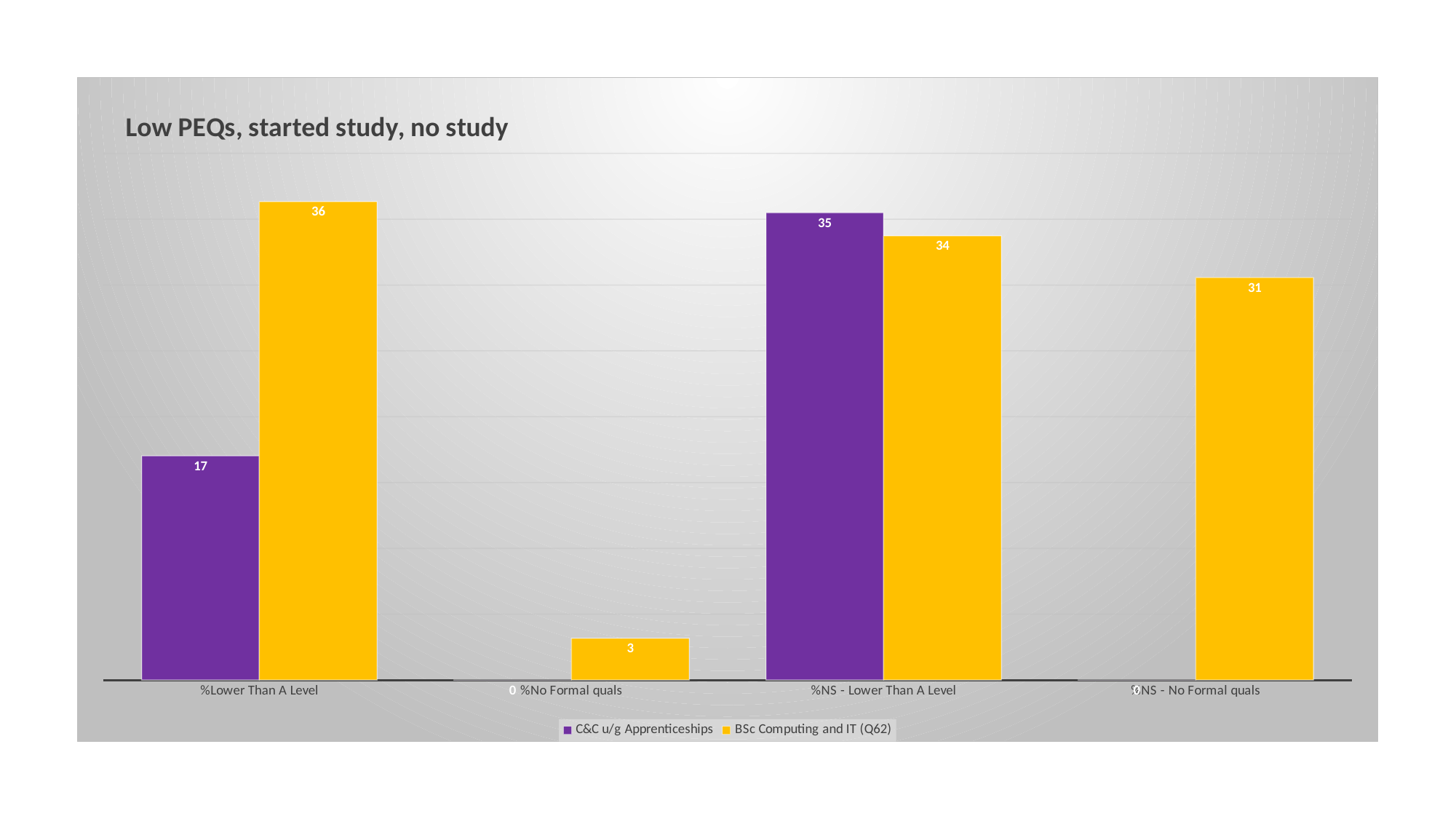
What is the difference between the BSc Computing and IT (Q62) value and the C&C u/g Apprenticeships value in the %Lower Than A Level category? 19 What type of chart is shown on the slide? bar chart What is the value for BSc Computing and IT (Q62) in the %NS - No Formal quals category? 31 What is the title of the chart? Low PEQs, started study, no study How many categories are shown on the x axis? 4 How many series does the legend list? 2 Which category has the lowest value for BSc Computing and IT (Q62)? %No Formal quals What is the value for BSc Computing and IT (Q62) in the %No Formal quals category? 3 What is the value for BSc Computing and IT (Q62) in the %Lower Than A Level category? 36 Which series has the larger value in the %Lower Than A Level category? BSc Computing and IT (Q62) Which category has the highest value for BSc Computing and IT (Q62)? %Lower Than A Level What is the value for C&C u/g Apprenticeships in the %NS - Lower Than A Level category? 35